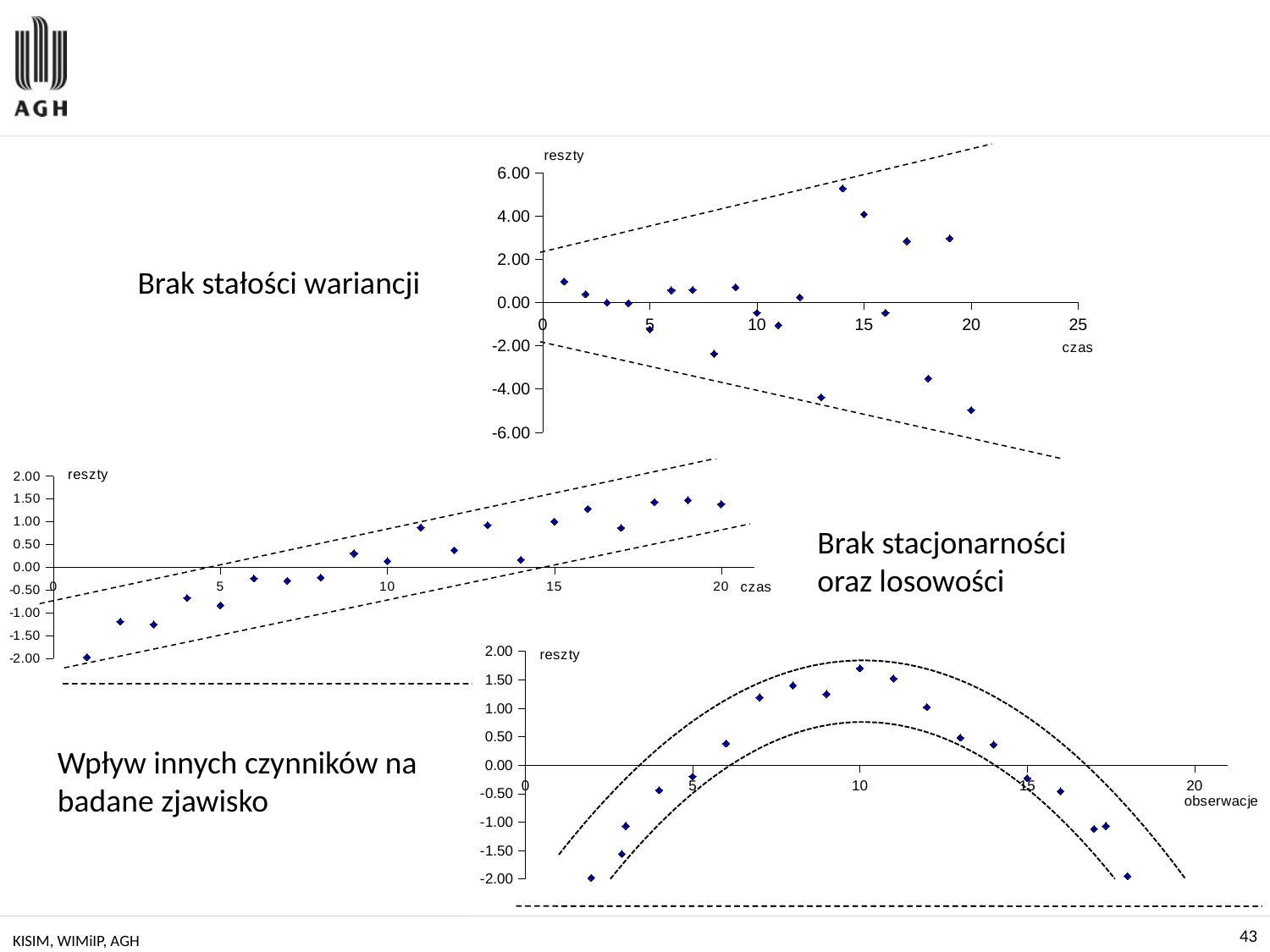
In the top-right chart, is the value at time 18 greater or less than -2.00? less In the top-right chart, at which time (czas) value is the lowest point plotted? 20 What kind of chart is the top-right chart on the slide? scatter chart What is the label of the horizontal axis of the bottom-right chart? obserwacje In the bottom-right chart, is the value at observation 10 greater or less than 1.50? greater In the top-right chart, is the value at time 14 greater or less than 4.00? greater How many data points are plotted in the top-right chart? 20 In the top-right chart, at which time (czas) value is the highest point plotted? 14 In the middle-left chart, do the plotted values generally rise or fall as time (czas) increases? rise What is the label of the vertical axis of the top-right chart? reszty In the middle-left chart, at which time (czas) value is the lowest point plotted? 1